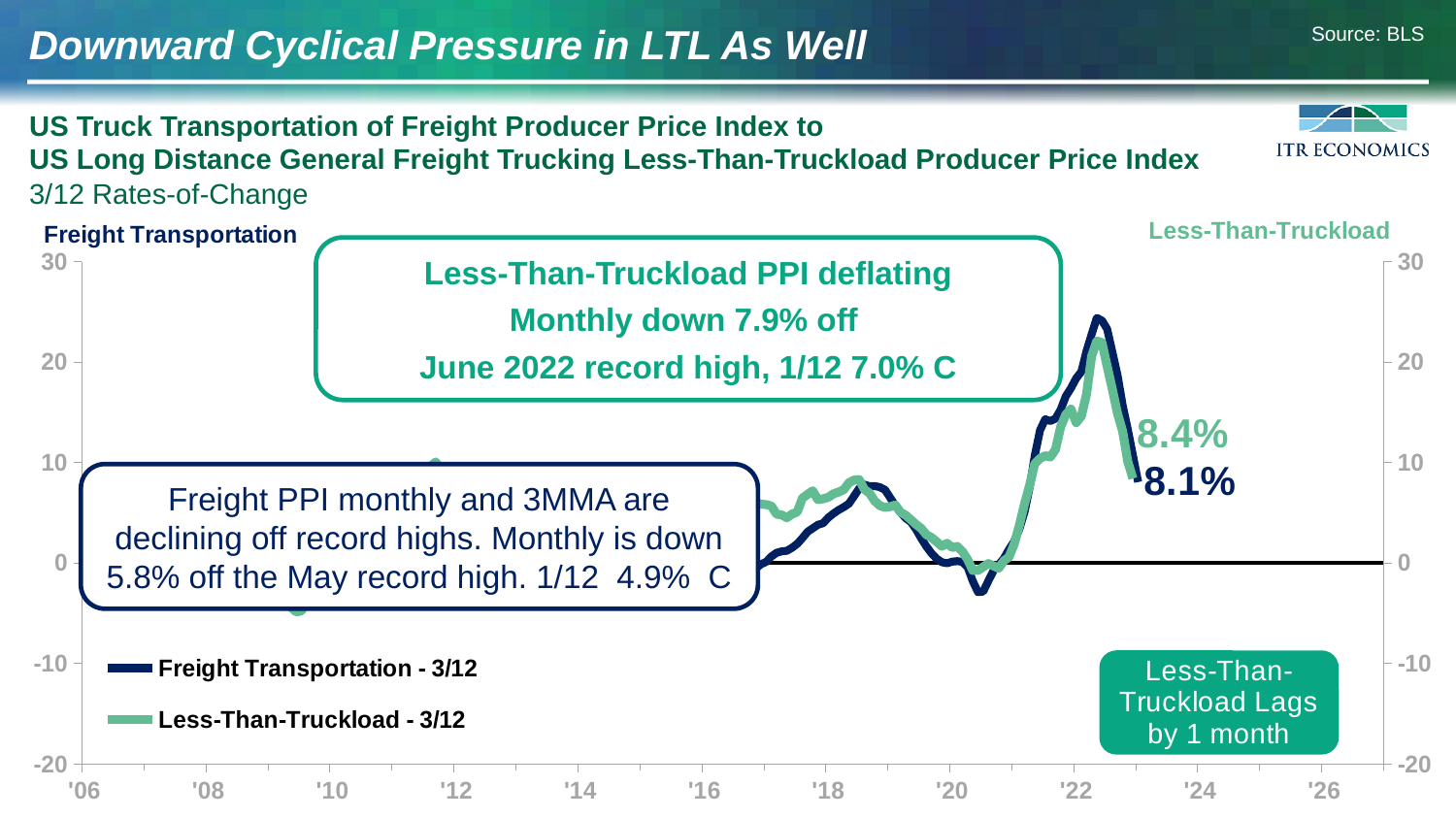
What is the difference between the latest labelled values of Less-Than-Truckload - 3/12 (8.4%) and Freight Transportation - 3/12 (8.1%)? 0.3% At the latest labelled point, which series has the higher value, Freight Transportation - 3/12 or Less-Than-Truckload - 3/12? Less-Than-Truckload - 3/12 What rate-of-change measure does the chart subtitle say is plotted? 3/12 Rates-of-Change What colour is the Less-Than-Truckload - 3/12 line in the chart? green Is the value of the Freight Transportation - 3/12 series at its peak around 2018 greater or less than 10? less What type of chart is shown on the slide? line chart Is the peak value of the Freight Transportation - 3/12 series around 2022 greater or less than 20? greater Is the value of the Freight Transportation - 3/12 series at its dip around 2020 greater or less than 0? less What is the latest labelled value for the Freight Transportation - 3/12 series? 8.1% What is the latest labelled value for the Less-Than-Truckload - 3/12 series? 8.4% How many series does the chart legend list? 2 From the 2022 peak to the latest labelled point, do the values of both series rise or fall? fall